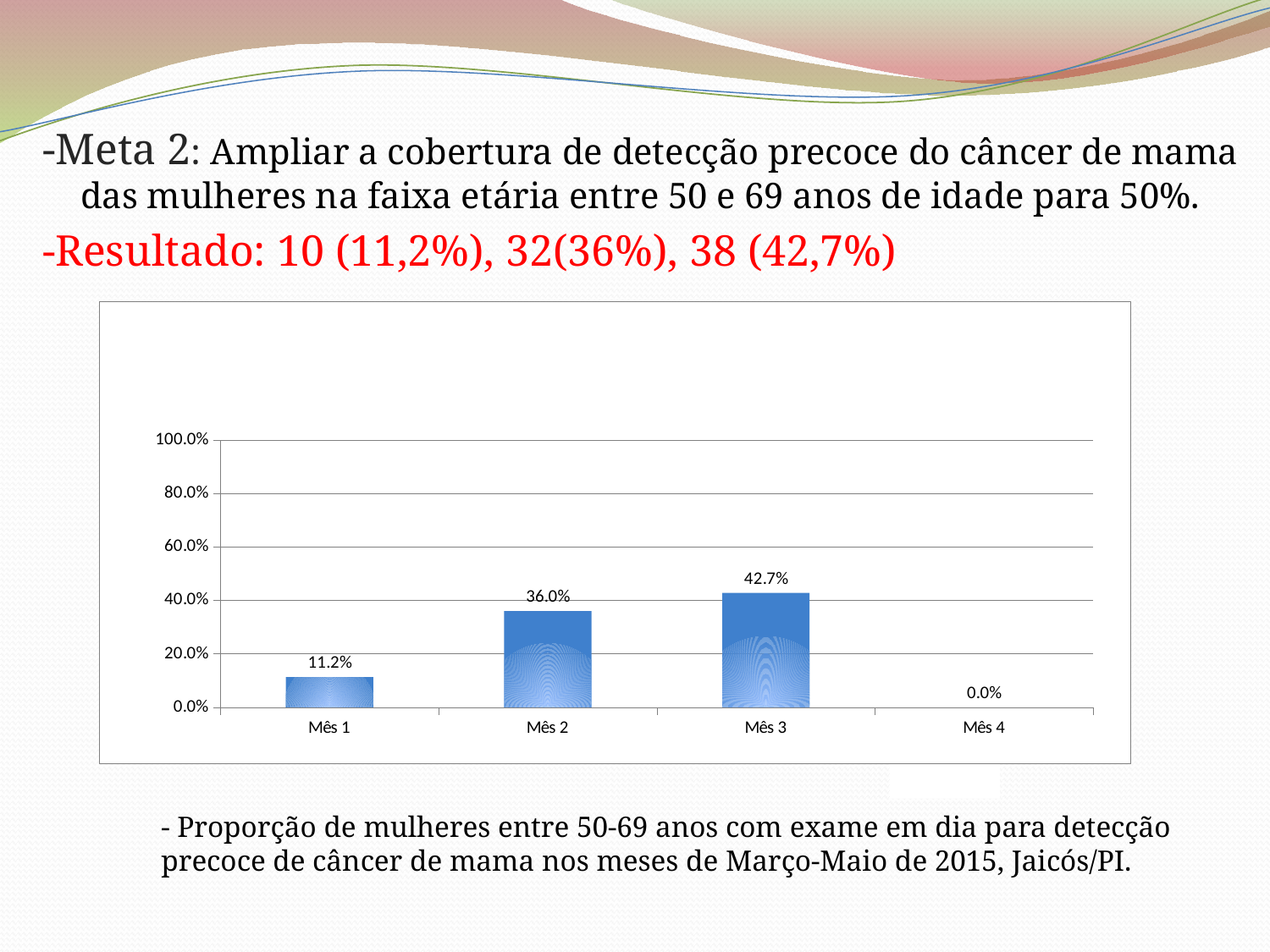
What is the difference between the values for Mês 3 and Mês 2? 6.7% What is the difference between the values for Mês 2 and Mês 1? 24.8% Which month has the highest value? Mês 3 What is the value for Mês 2? 36.0% How many categories are shown on the x axis? 4 What is the value for Mês 4? 0.0% What is the value for Mês 1? 11.2% Which month has the lowest value? Mês 4 What kind of chart is shown on the slide? bar chart Which is larger, the value for Mês 1 or the value for Mês 2? Mês 2 What is the value for Mês 3? 42.7% Is the value for Mês 3 greater or less than 40.0%? greater